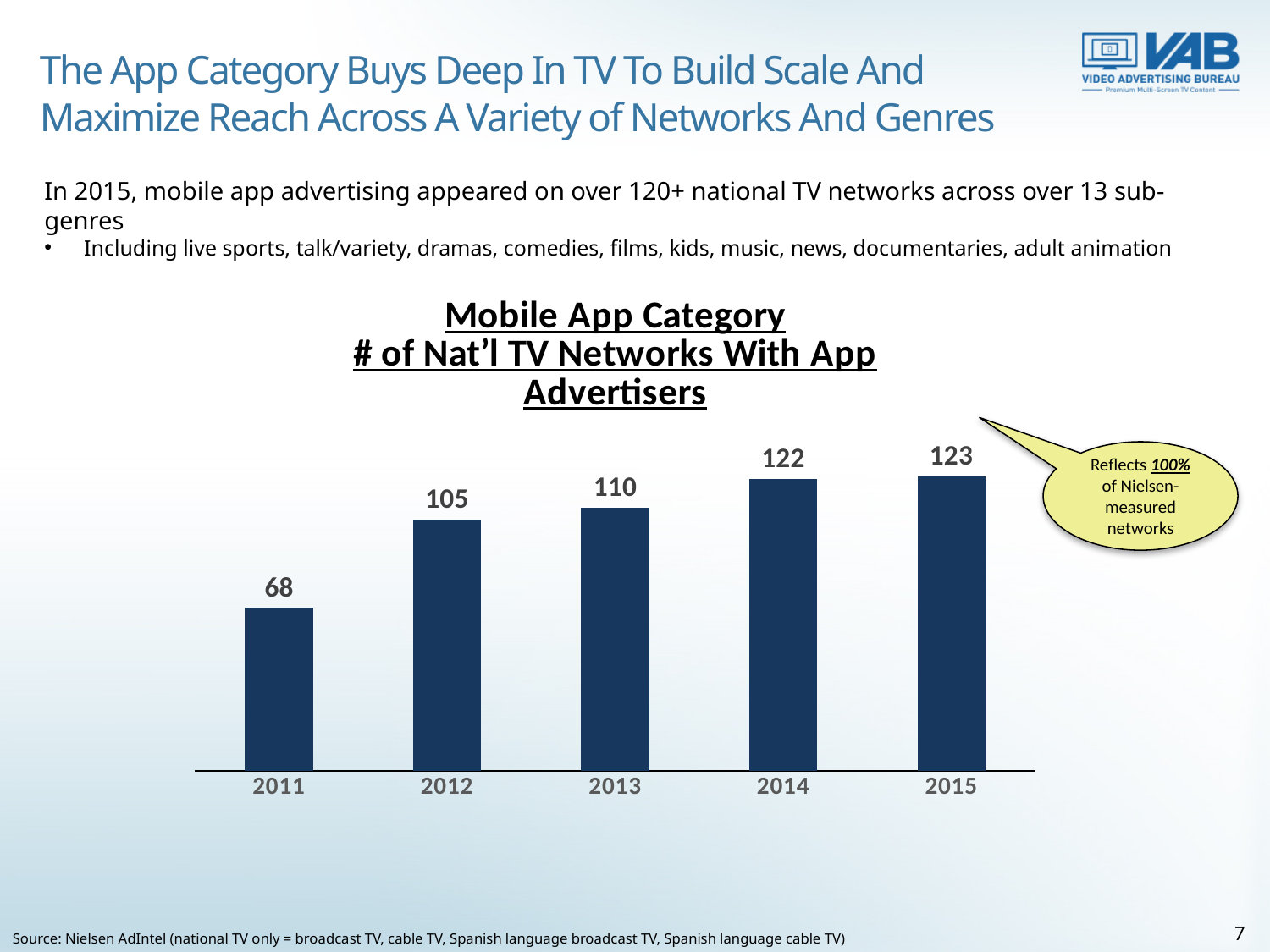
How many years are shown on the chart? 5 What is the difference between the 2015 and 2011 values? 55 Which year has the lowest number of national TV networks with app advertisers? 2011 What is the number of national TV networks with app advertisers in 2011? 68 What is the difference between the 2012 and 2011 values? 37 Which is larger, the value for 2012 or the value for 2014? 2014 What kind of chart is shown on the slide? Bar chart What is the number of national TV networks with app advertisers in 2013? 110 What is the title of the chart? Mobile App Category # of Nat'l TV Networks With App Advertisers Do the values rise or fall from 2011 to 2015? Rise What is the number of national TV networks with app advertisers in 2015? 123 Which year has the highest number of national TV networks with app advertisers? 2015